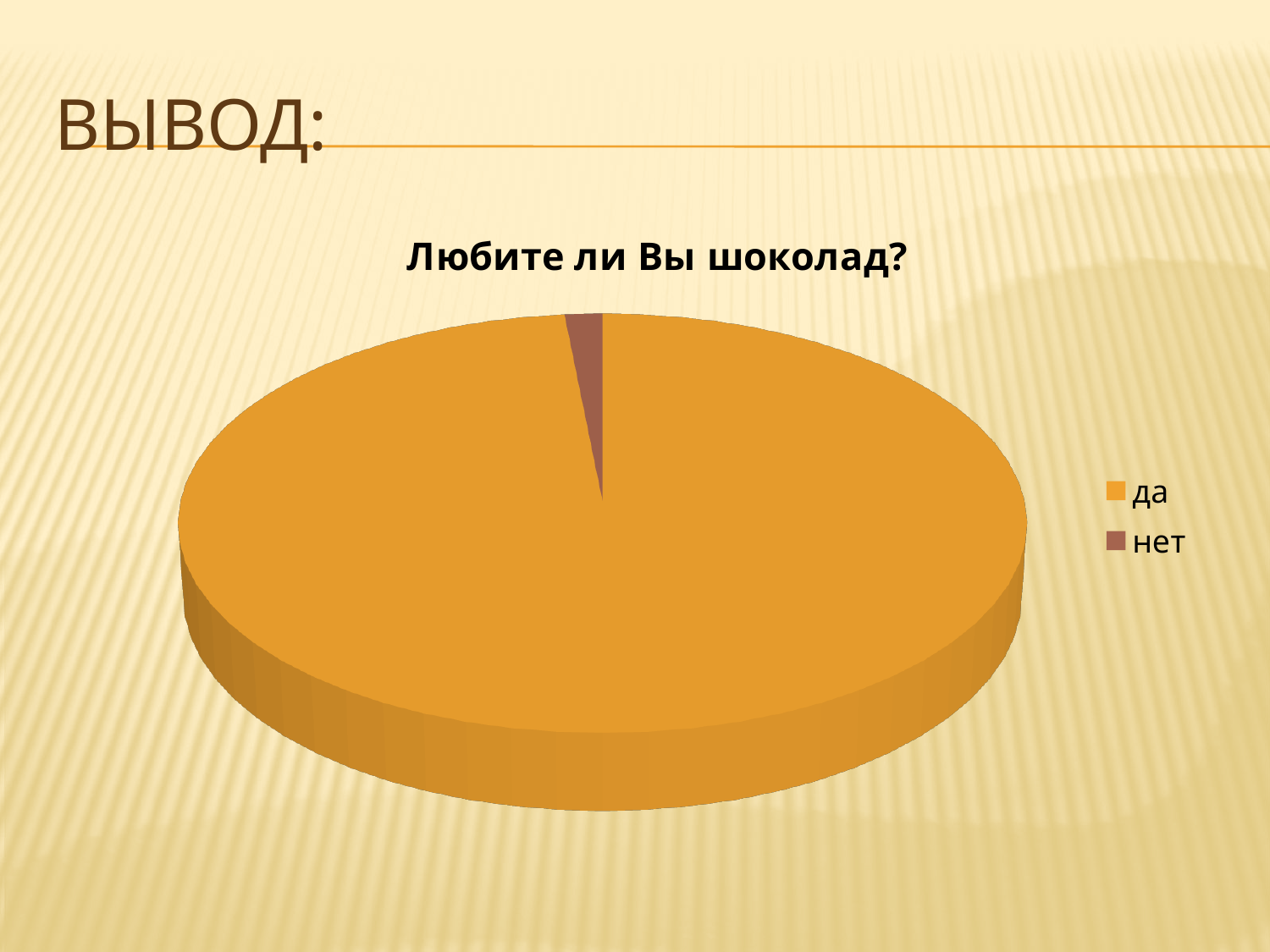
What is the title of the chart? Любите ли Вы шоколад? Is the share of the "нет" slice greater or less than 25%? less Is the share of the "да" slice greater or less than 50%? greater Which category has the smallest slice of the pie? нет Which slice is larger, "да" or "нет"? да Which category has the largest slice of the pie? да What colour is the slice for "нет"? brown What kind of chart is shown on the slide? pie chart How many categories does the legend list? 2